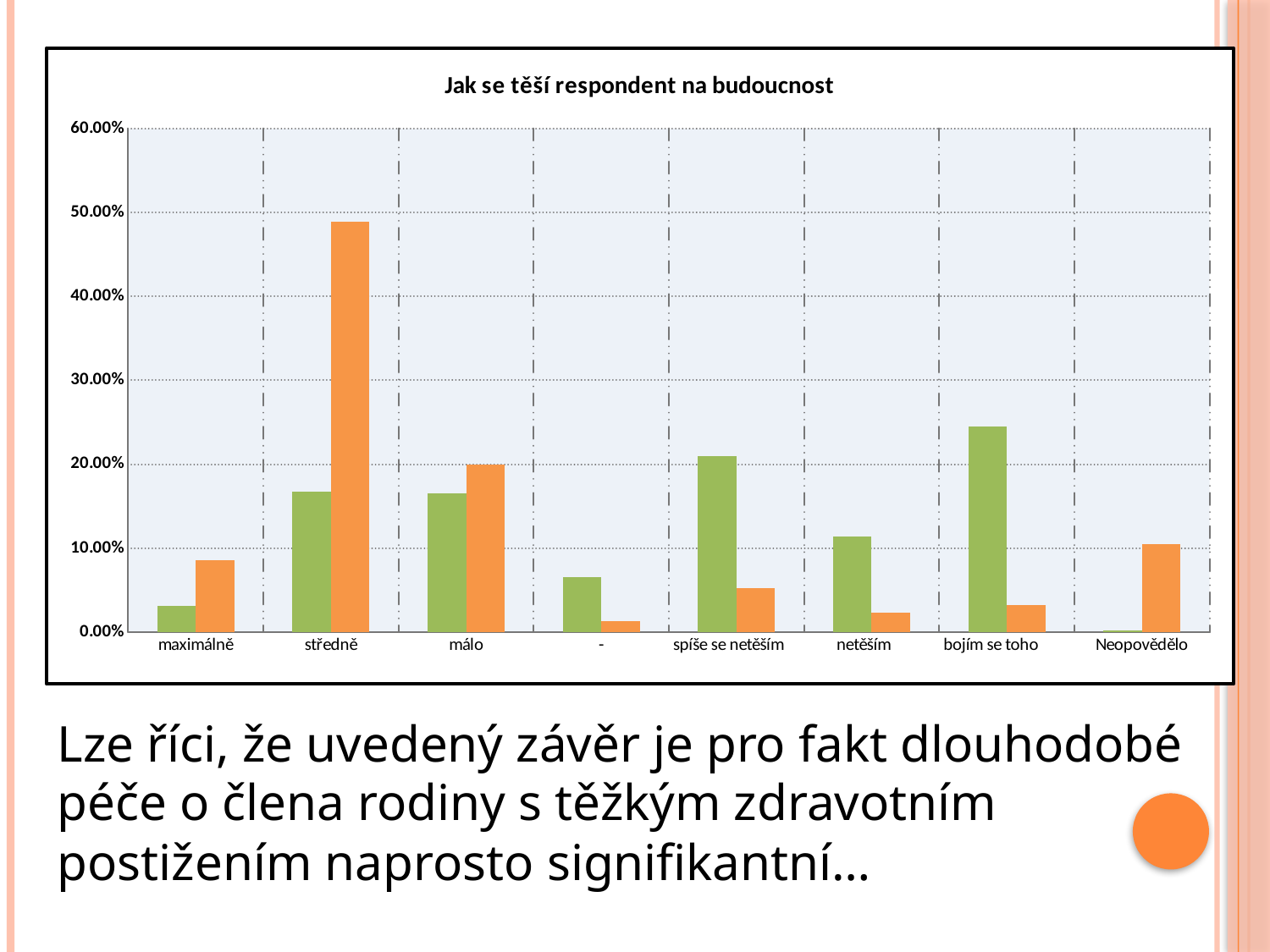
Is the green bar for bojím se toho greater or less than 20.00%? greater Which category has the highest green bar? bojím se toho Is the orange bar for středně greater or less than 40.00%? greater How many categories are shown on the x axis of the chart? 8 For the category středně, which bar is taller, the green one or the orange one? orange For the category bojím se toho, which bar is taller, the green one or the orange one? green What kind of chart is shown on the slide? bar chart What is the title of the chart? Jak se těší respondent na budoucnost Which category has the lowest green bar? Neopovědělo Is the orange bar for maximálně greater or less than 10.00%? less Which category has the highest orange bar? středně How many differently coloured bar series are plotted for each category? 2